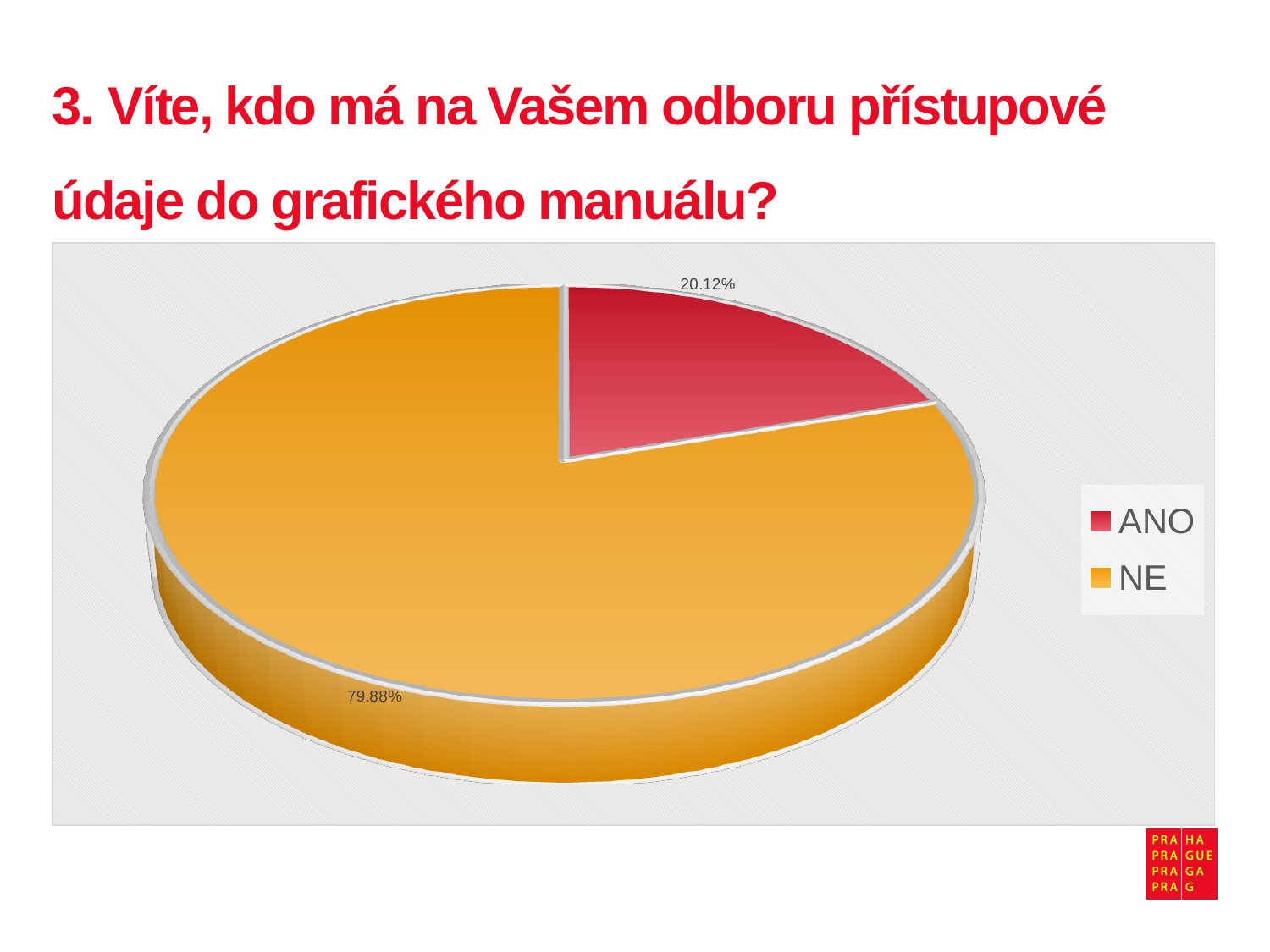
What percentage of the pie is labelled ANO? 20.12% How many entries does the legend list? 2 What kind of chart is shown on the slide? pie chart What colour is the NE slice? orange What is the difference in percentage points between the NE slice and the ANO slice? 59.76 Which slice is the largest? NE What is the share of the pie taken by the NE slice? 79.88% Which slice is the smallest? ANO What colour is the ANO slice? red How many slices does the pie chart have? 2 Which is larger, the ANO slice or the NE slice? NE What percentage of the pie is labelled NE? 79.88%